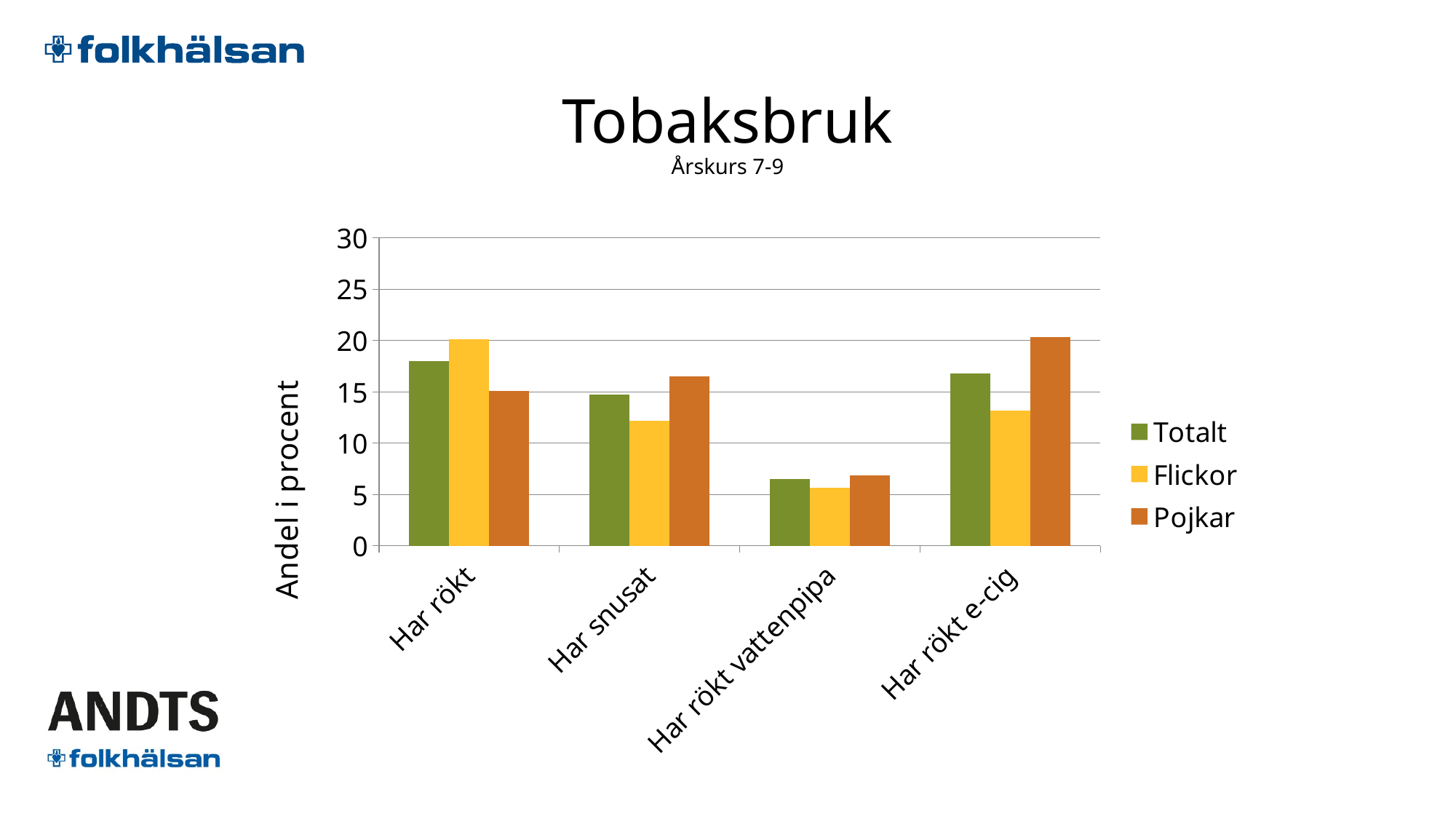
Is the value for Flickor in Har rökt vattenpipa greater or less than 10? less Which category has the highest value for Pojkar? Har rökt e-cig Which category has the highest value for Flickor? Har rökt How many series does the legend list? 3 What is the label of the y axis? Andel i procent What kind of chart is shown on the slide? bar chart Which category has the lowest value for Totalt? Har rökt vattenpipa Is the value for Totalt in Har rökt greater or less than 15? greater For Har snusat, which is larger: Flickor or Pojkar? Pojkar How many categories are shown on the x axis? 4 For Har rökt, which is larger: Flickor or Pojkar? Flickor